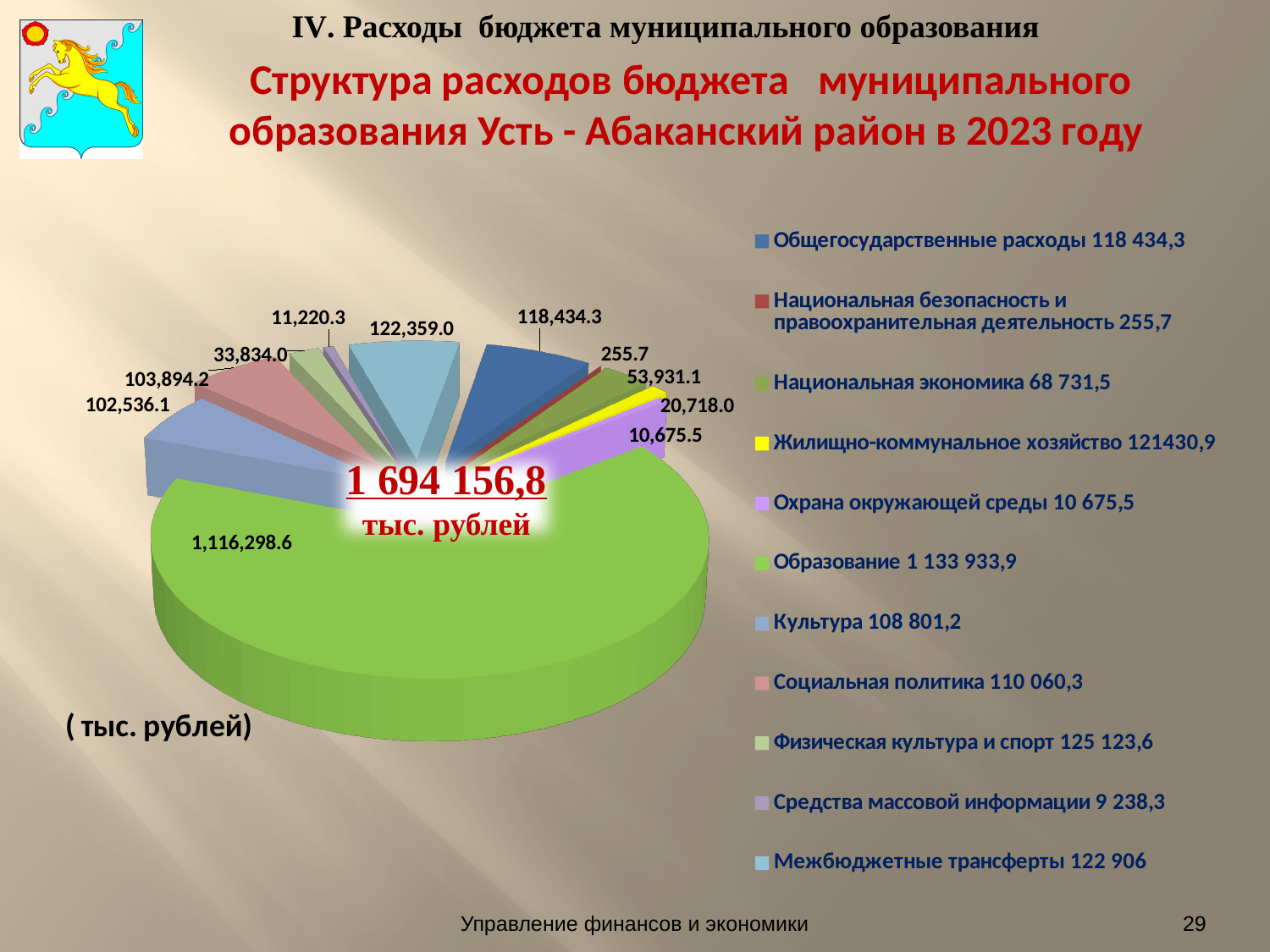
Which category has the largest slice of the pie chart? Образование How many slices (categories) does the pie chart have? 11 What year does the chart title say the budget expenditure structure refers to? 2023 What kind of chart is shown on the slide? pie chart What is the value shown for Общегосударственные расходы? 118,434.3 What is the value shown for Охрана окружающей среды? 10,675.5 What is the difference between the values for Общегосударственные расходы (118,434.3) and Национальная безопасность и правоохранительная деятельность (255.7)? 118,178.6 What total amount is printed in the centre of the pie chart? 1 694 156,8 тыс. рублей What is the value shown for Национальная безопасность и правоохранительная деятельность? 255.7 Which category has the smallest slice of the pie chart? Национальная безопасность и правоохранительная деятельность How many entries does the legend of the pie chart list? 11 Which is larger: Общегосударственные расходы or Охрана окружающей среды? Общегосударственные расходы